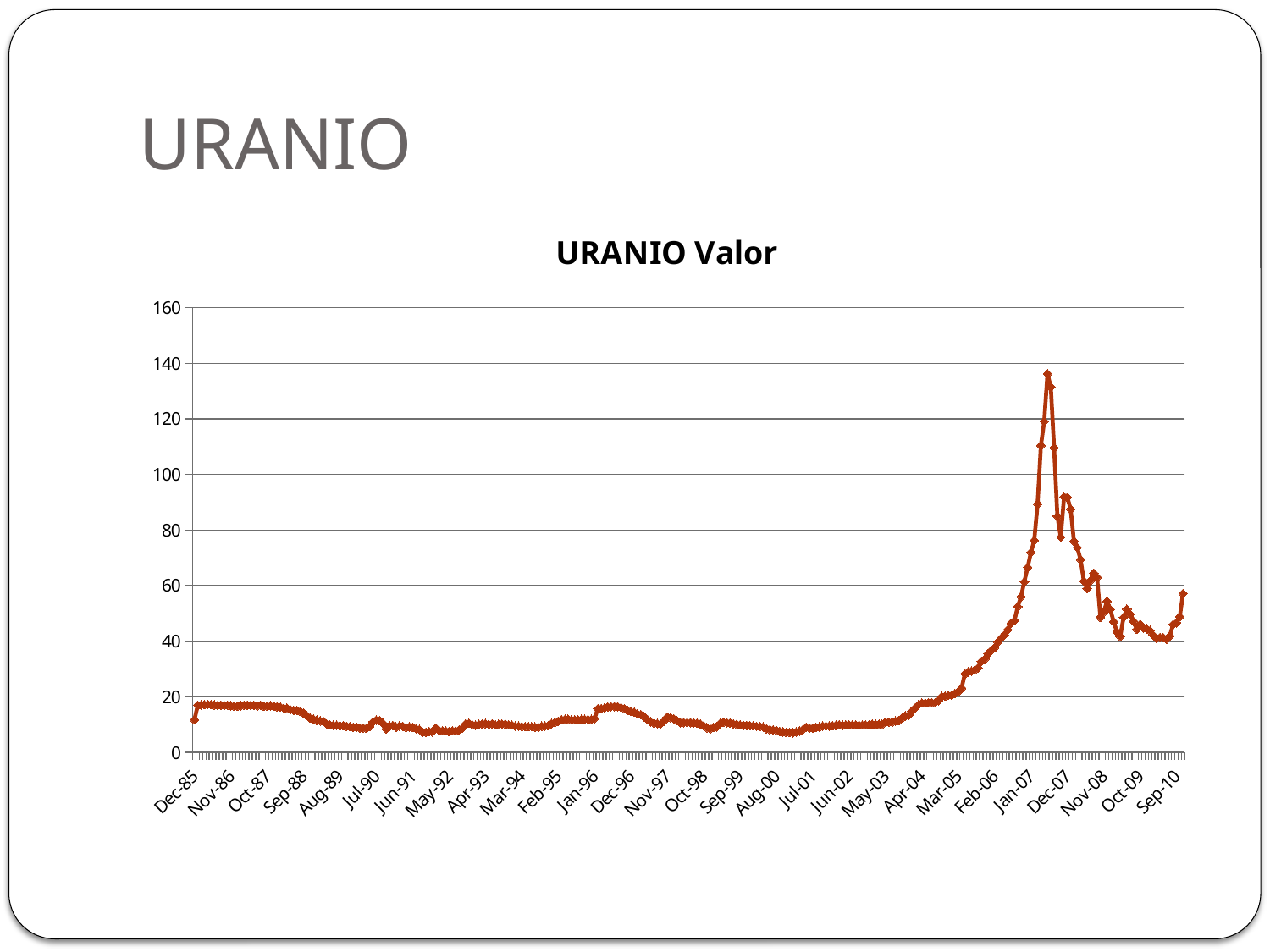
Is the value at Dec-85 greater or less than 20? less Is the value at Sep-10 greater or less than 40? greater Do the values generally rise or fall between Dec-07 and Oct-09? fall Is the peak value of the line greater or less than 140? less What is the title of the chart? URANIO Valor Which is larger, the value at Sep-10 or the value at Dec-85? Sep-10 What kind of chart is shown on the slide? line chart Do the values rise or fall between Mar-05 and the peak in 2007? rise Which is larger, the value at Dec-07 or the value at Nov-08? Dec-07 What is the highest value shown on the vertical axis of the chart? 160